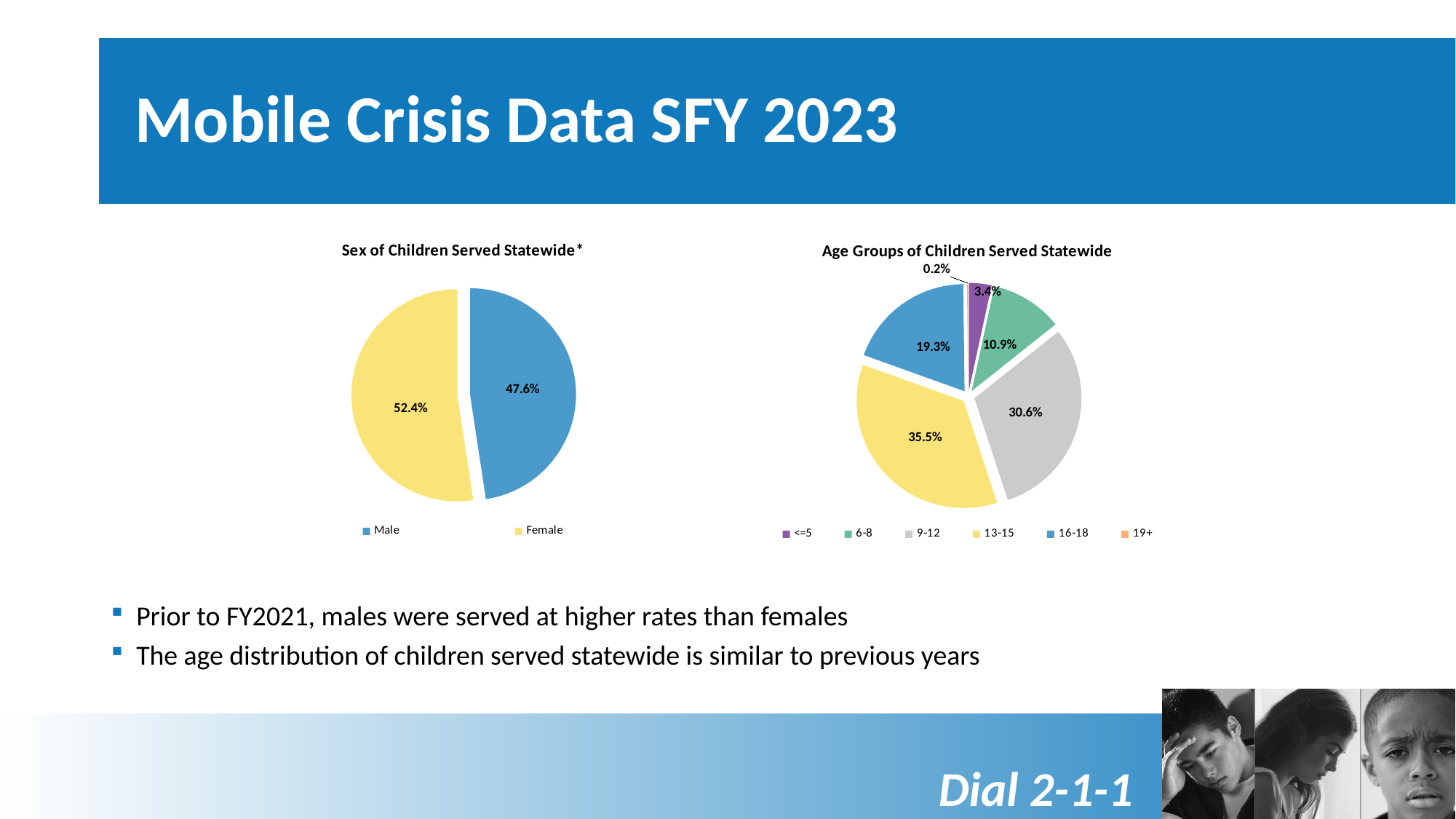
In the 'Age Groups of Children Served Statewide' chart, which age group has the largest share? 13-15 In the 'Sex of Children Served Statewide' chart, which category has the larger share, Male or Female? Female In the 'Sex of Children Served Statewide' chart, what percentage of children served were male? 47.6% In the 'Age Groups of Children Served Statewide' chart, which age group has the smallest share? 19+ In the 'Age Groups of Children Served Statewide' chart, what percentage of children served were aged 13-15? 35.5% In the 'Age Groups of Children Served Statewide' chart, what is the difference in percentage points between the 9-12 and 6-8 age groups? 19.7 In the 'Age Groups of Children Served Statewide' chart, what percentage of children served were aged 9-12? 30.6% In the 'Sex of Children Served Statewide' chart, what is the difference in percentage points between the Female and Male shares? 4.8 In the 'Age Groups of Children Served Statewide' chart, what percentage of children served were aged 16-18? 19.3% How many age groups does the legend of the 'Age Groups of Children Served Statewide' chart list? 6 What kind of chart is 'Age Groups of Children Served Statewide'? Pie chart In the 'Sex of Children Served Statewide' chart, what percentage of children served were female? 52.4%